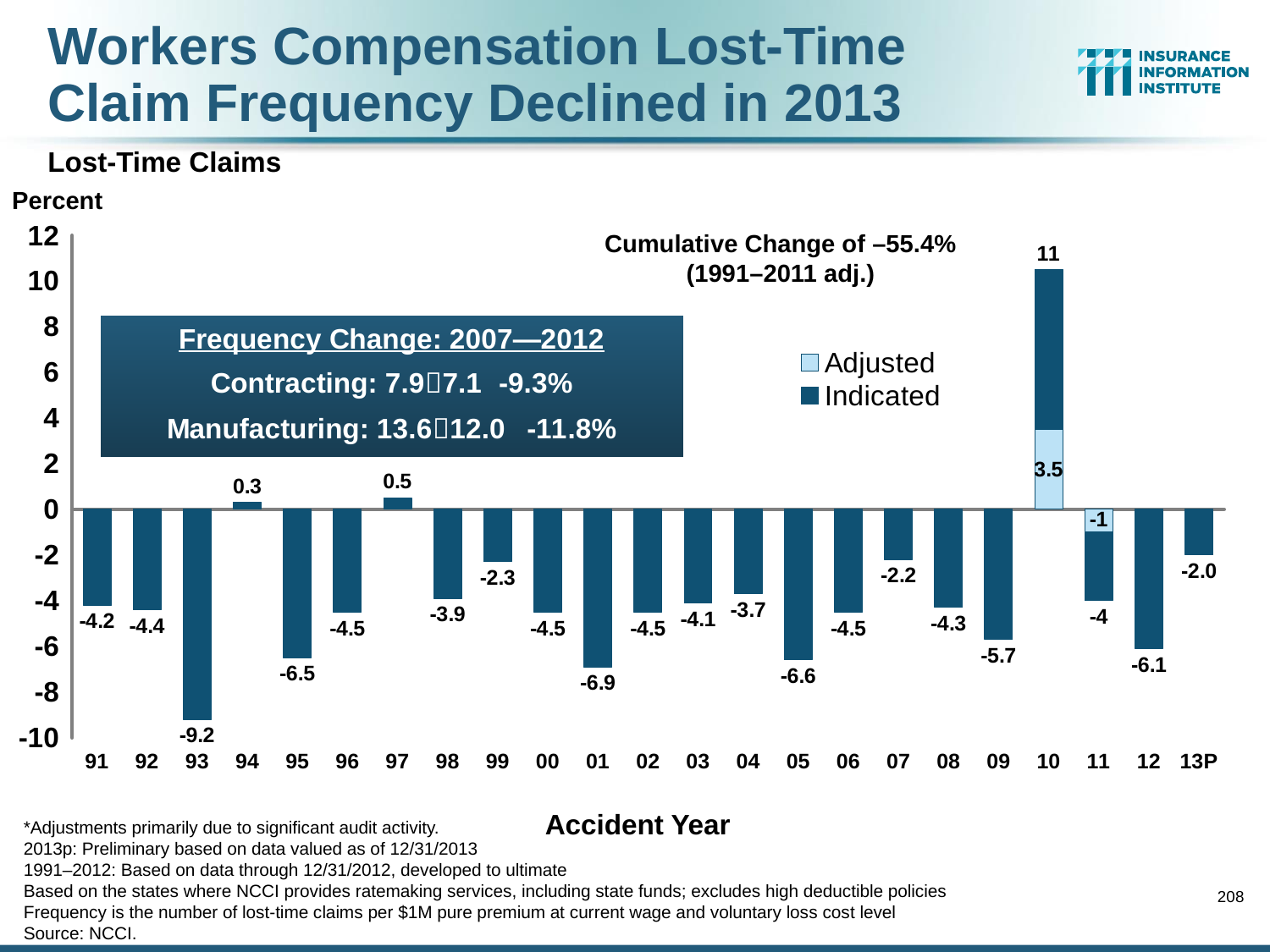
What type of chart is shown on the slide? bar chart How many accident years are shown on the x axis? 23 What is the value for accident year 13P? -2.0 How many series does the legend list? 2 What cumulative change (1991–2011 adj.) is stated on the chart? –55.4% Which accident year has the lowest value? 93 What is the difference between the values for accident years 12 and 13P? 4.1 Which is larger, the value for accident year 98 or for accident year 99? 99 What is the Adjusted value for accident year 10? 3.5 What is the Indicated value for accident year 10? 11 What is the value for accident year 93? -9.2 Which accident year has the highest value? 10